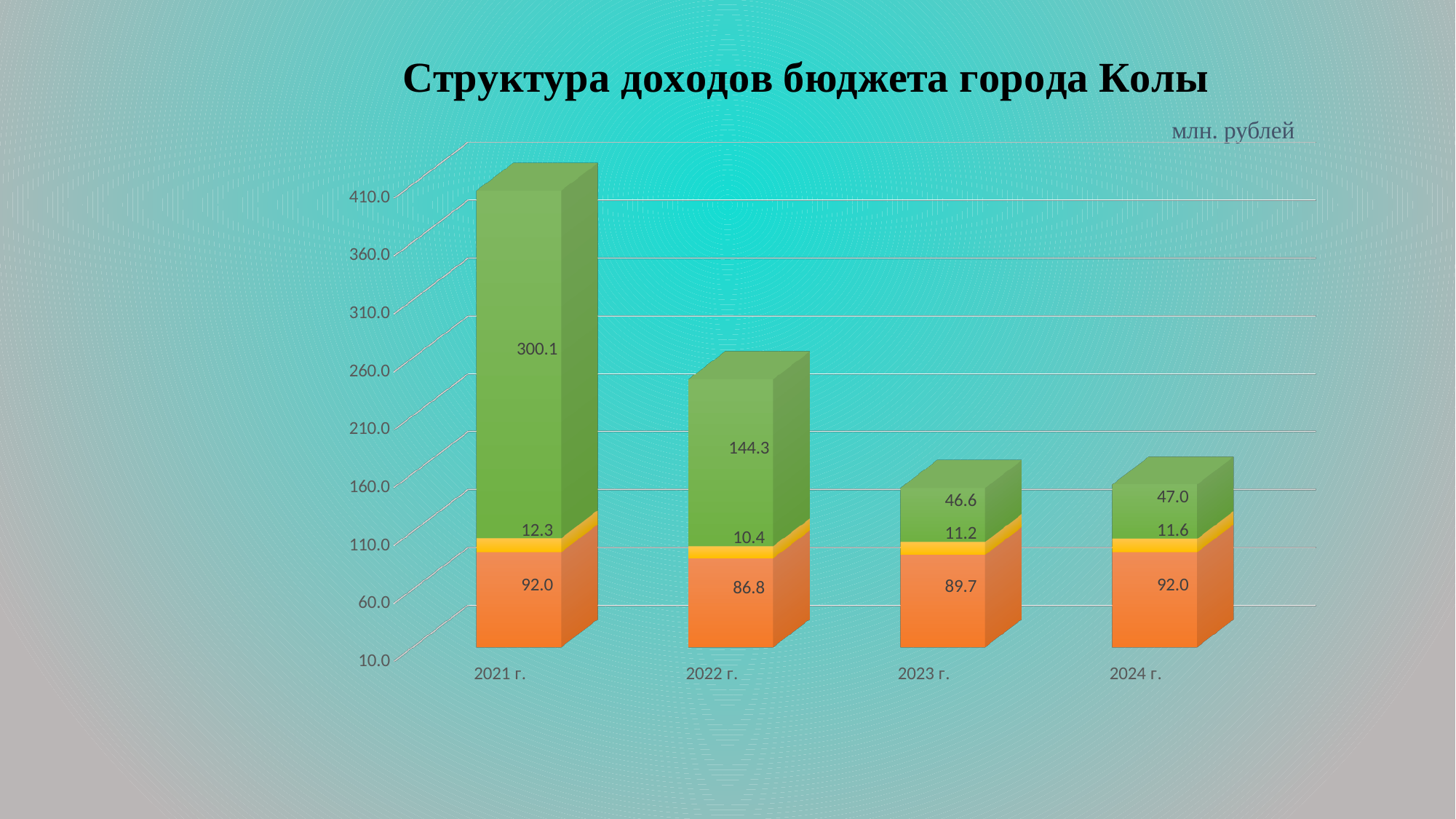
In which year is the green segment the largest? 2021 г. What is the value of the green segment for 2021 г.? 300.1 In which year is the orange segment the smallest? 2022 г. What is the total of the stacked bar for 2023 г.? 147.5 What type of chart is shown on the slide? stacked bar chart Which is larger, the orange segment for 2023 г. or the orange segment for 2024 г.? 2024 г. How many years (categories) are shown on the x axis? 4 What unit is indicated for the values on the chart? млн. рублей What is the title of the chart? Структура доходов бюджета города Колы What is the difference between the green segment values for 2021 г. and 2022 г.? 155.8 What is the value of the yellow segment for 2024 г.? 11.6 What is the value of the orange segment for 2022 г.? 86.8